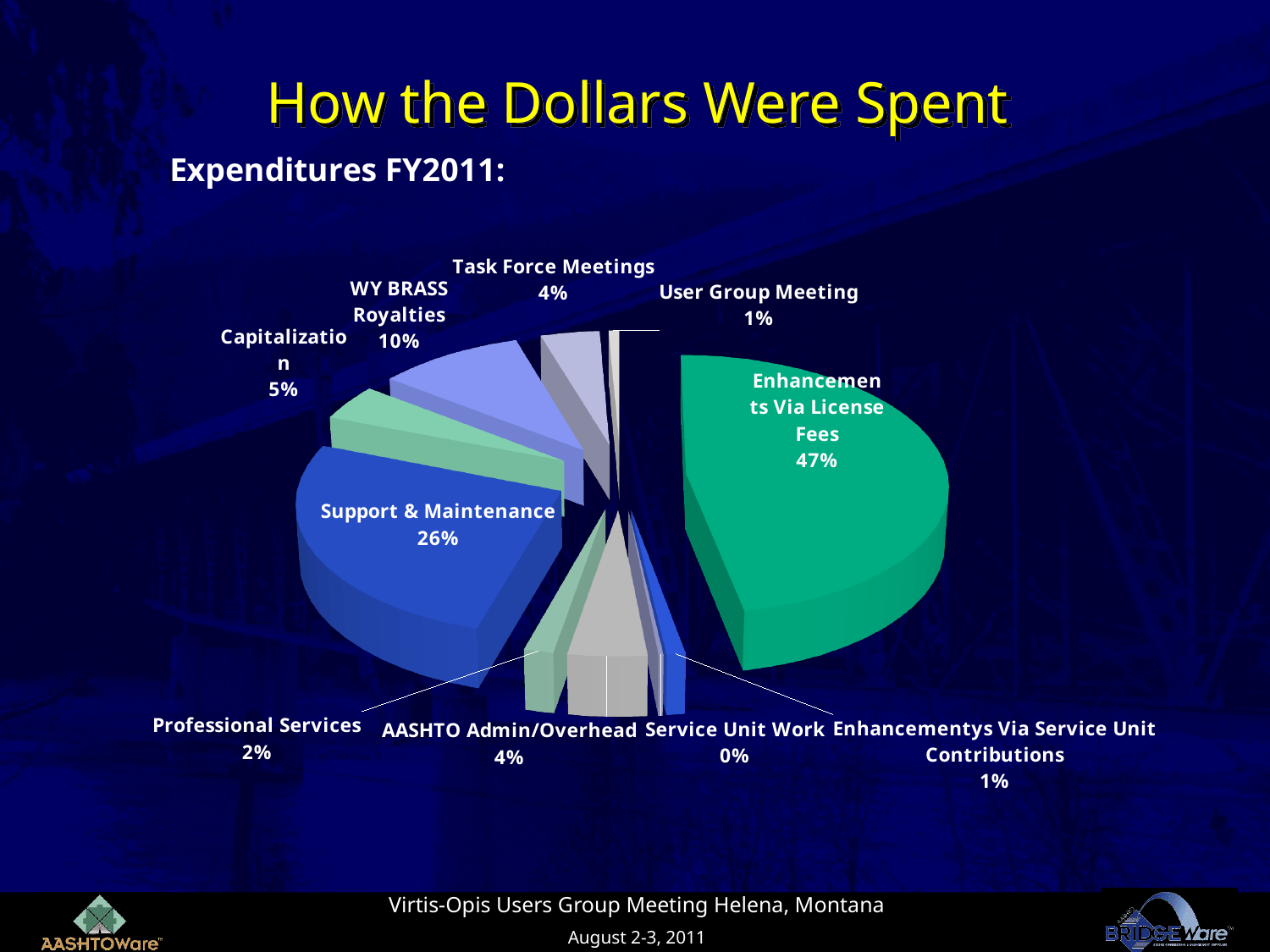
What share of FY2011 expenditures went to Enhancements Via License Fees? 47% How many categories are shown in the pie chart? 10 Which category has the largest share of expenditures? Enhancements Via License Fees What percentage is shown for Professional Services? 2% Which category has the smallest share of expenditures? Service Unit Work What share of FY2011 expenditures went to Support & Maintenance? 26% What kind of chart is shown on the slide? Pie chart Which is larger, WY BRASS Royalties or Capitalization? WY BRASS Royalties What percentage is shown for Capitalization? 5% What percentage is shown for WY BRASS Royalties? 10% How many percentage points larger is Enhancements Via License Fees than Support & Maintenance? 21 What is the subtitle above the chart? Expenditures FY2011: